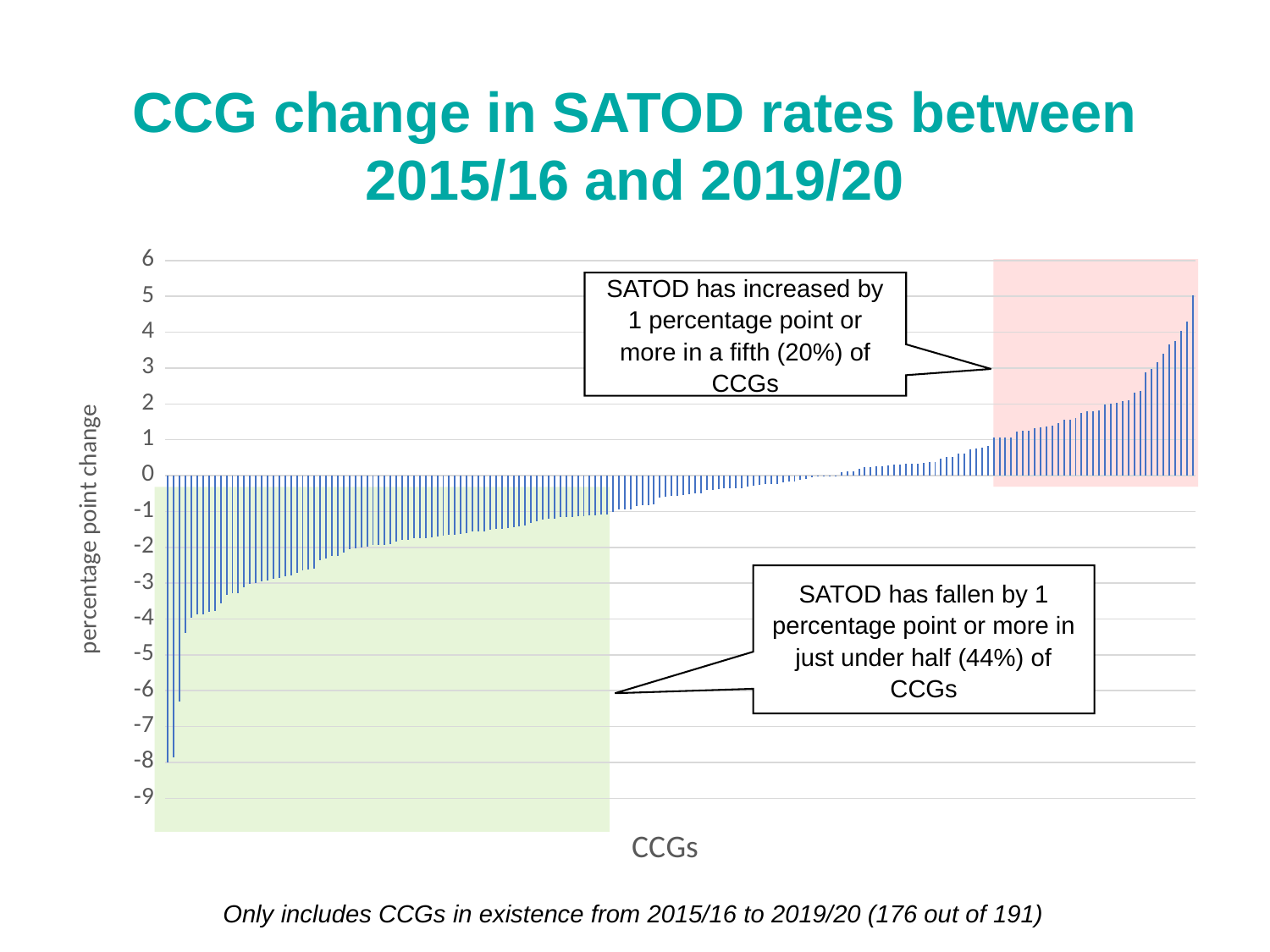
What is the highest value shown on the vertical axis of the chart? 6 Is the highest bar value on the chart greater or less than 6? less Do the bar values rise or fall moving from left to right along the x axis? Rise According to the chart annotation, in what share of CCGs has SATOD fallen by 1 percentage point or more? 44% Is the lowest bar value on the chart greater or less than -7? less Is the lowest bar value on the chart greater or less than -9? greater What kind of chart is shown on the slide? Bar chart How many CCGs are included in the chart, according to the note below it? 176 What is the title of the chart on the slide? CCG change in SATOD rates between 2015/16 and 2019/20 What is the label on the vertical axis of the chart? percentage point change According to the chart annotation, in what share of CCGs has SATOD increased by 1 percentage point or more? 20%